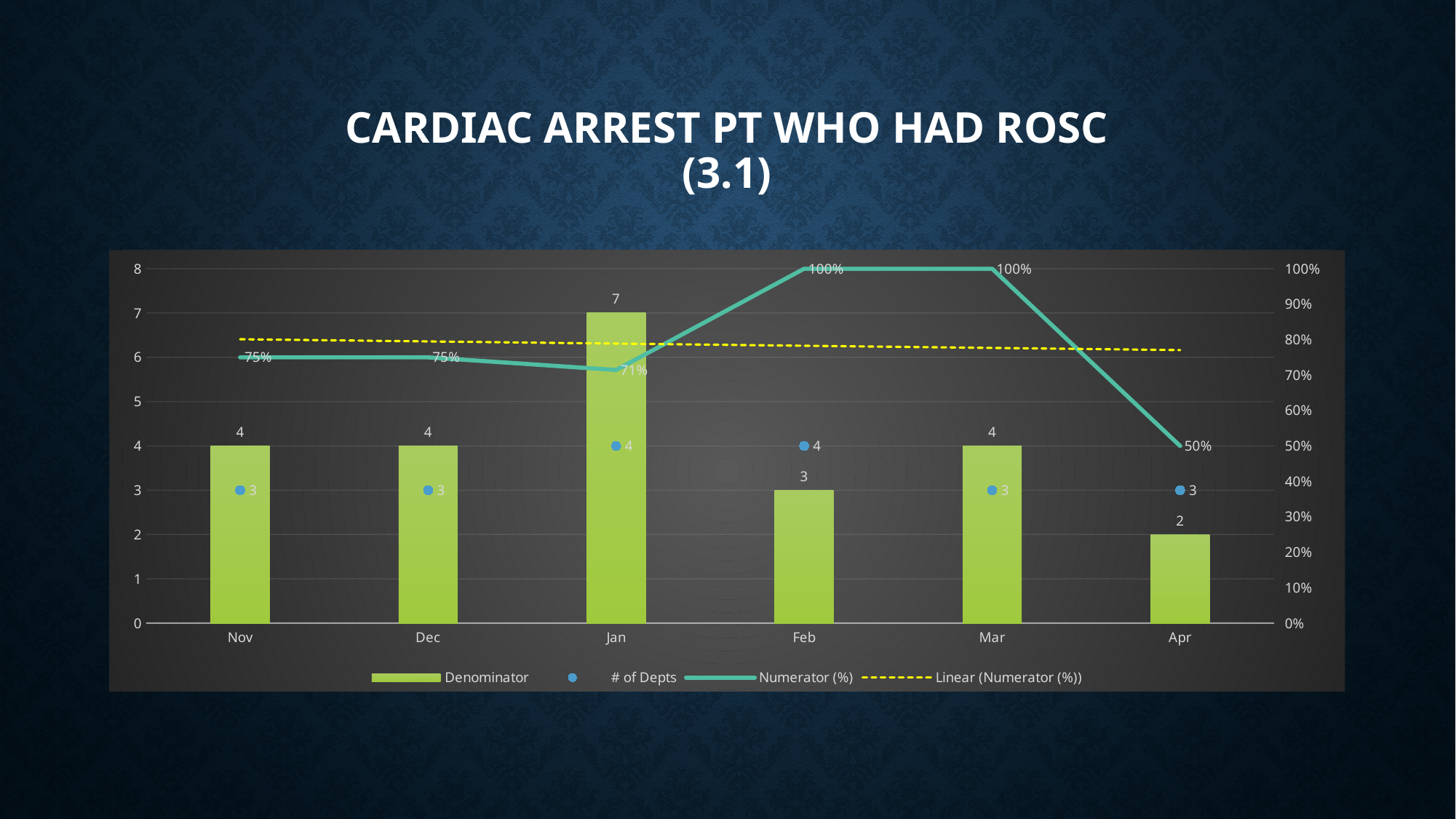
What is the Numerator (%) value for Apr? 50% What is the difference between the Denominator for Jan and the Denominator for Apr? 5 What kind of chart is used for the Denominator series? bar chart Which month has the lowest Denominator? Apr What is the Denominator value for Jan? 7 How many series does the legend list? 4 Which month has the highest Denominator? Jan What is the title of the chart? CARDIAC ARREST PT WHO HAD ROSC (3.1) What is the # of Depts value for Feb? 4 Does the Numerator (%) line rise or fall from Mar to Apr? fall How many months are shown on the x axis? 6 Which is larger, the Numerator (%) for Jan or the Numerator (%) for Feb? Feb